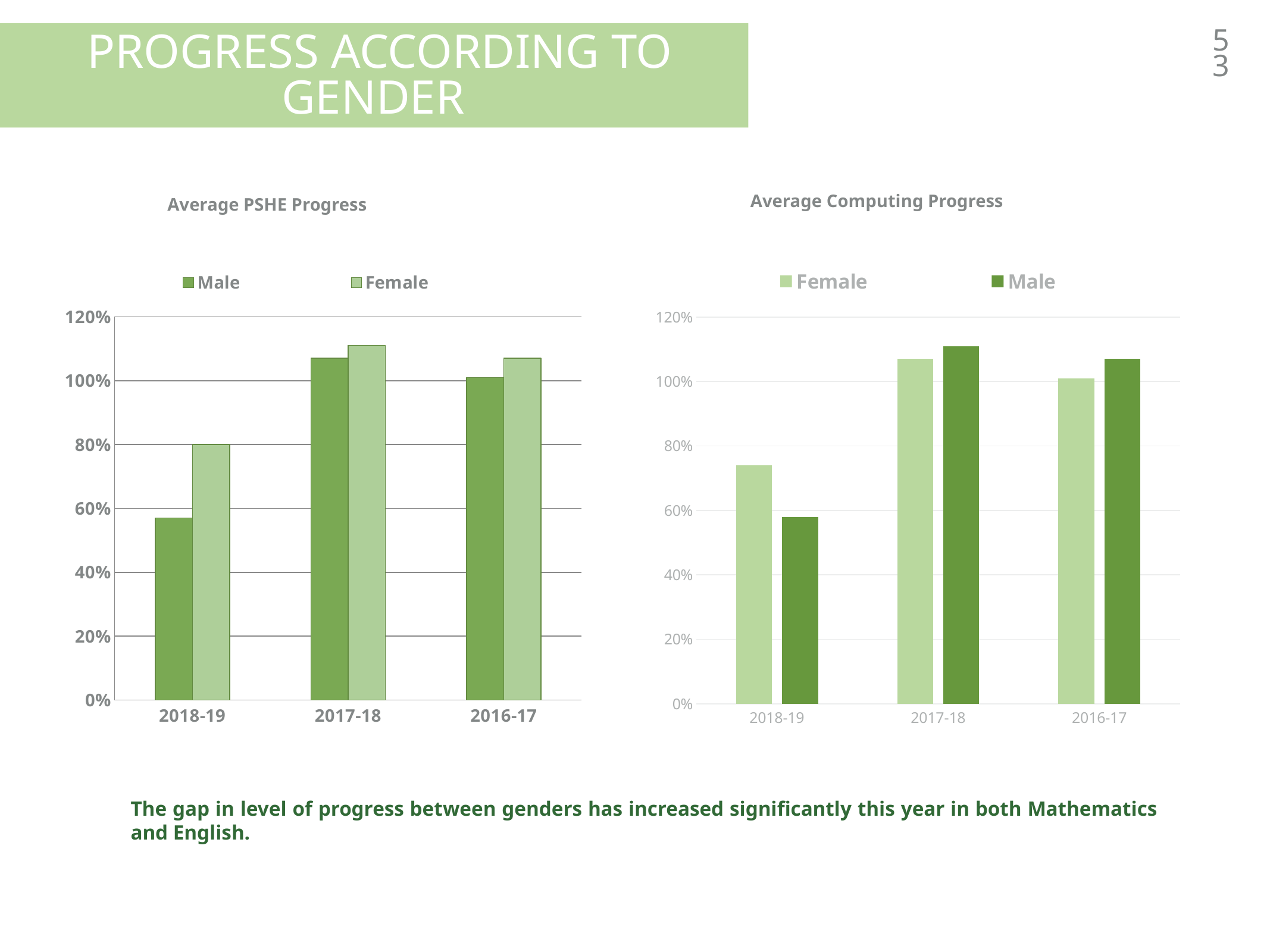
In the Average PSHE Progress chart, which is larger for 2018-19, the Male value or the Female value? Female In the Average Computing Progress chart, which year has the lowest Female value? 2018-19 In the Average Computing Progress chart, is the Male value for 2018-19 greater or less than 60%? less In the Average PSHE Progress chart, is the Male value for 2017-18 greater or less than 100%? greater In the Average PSHE Progress chart, which year has the highest Female value? 2017-18 In the Average PSHE Progress chart, is the Male value for 2018-19 greater or less than 60%? less In the Average PSHE Progress chart, which year has the lowest Male value? 2018-19 In the Average Computing Progress chart, which is larger for 2018-19, the Female value or the Male value? Female How many categories are shown on the x axis of the Average PSHE Progress chart? 3 How many series does the legend of the Average Computing Progress chart list? 2 What type of chart is the Average PSHE Progress chart? bar chart